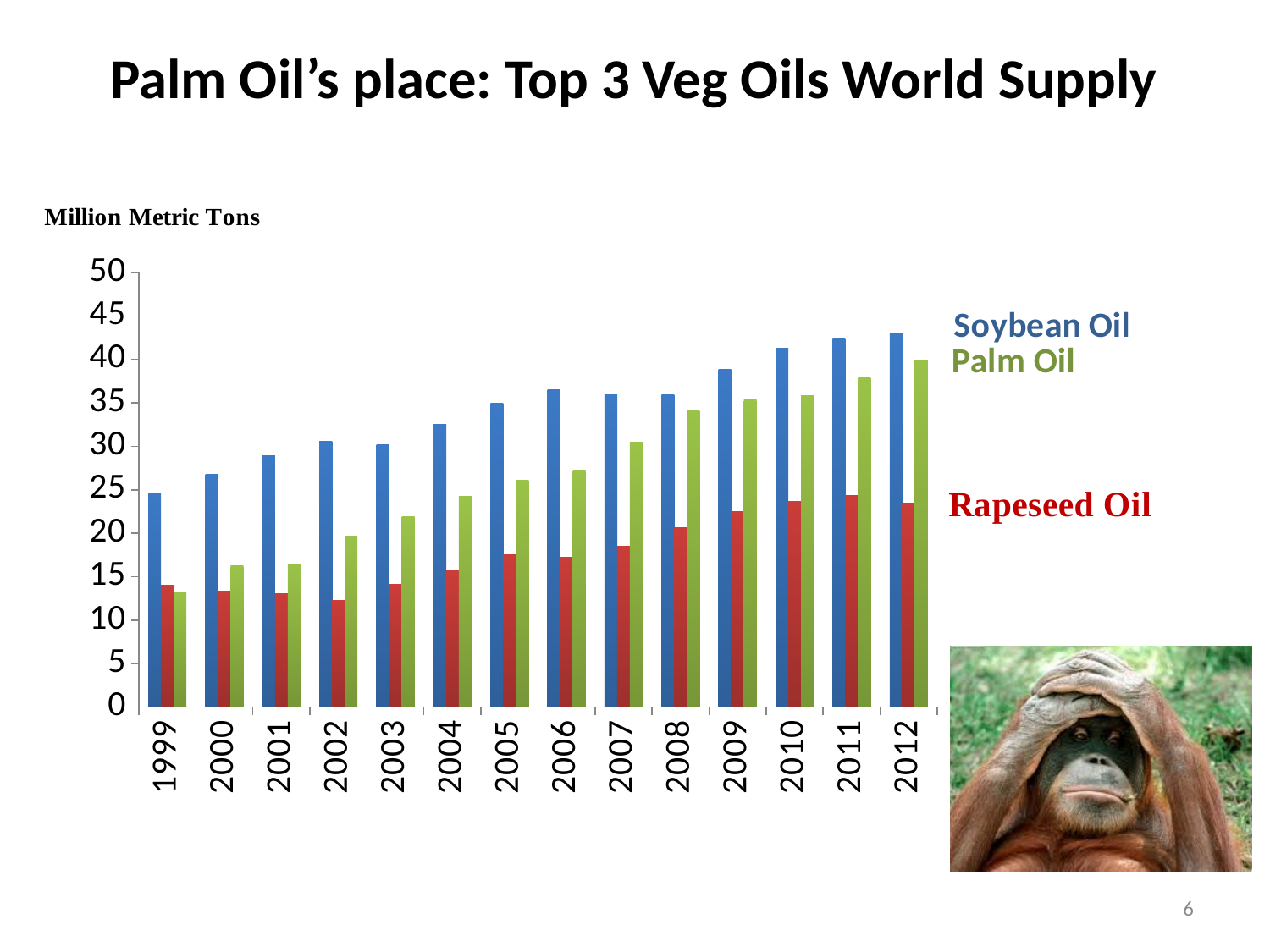
Is the Palm Oil value for 2008 greater or less than 30? greater Is the Soybean Oil value for 2012 greater or less than 40? greater How many series does the chart show? 3 In 2012, which is larger: Palm Oil or Rapeseed Oil? Palm Oil Is the Palm Oil value for 1999 greater or less than 15? less What unit is the chart's y axis measured in, according to the label above the chart? Million Metric Tons What kind of chart is shown on the slide? bar chart In which year is the Soybean Oil supply highest? 2012 Does the Palm Oil supply generally rise or fall from 1999 to 2012? rise In which year is the Rapeseed Oil supply lowest? 2002 How many years are shown along the x axis? 14 In 2000, which is larger: Palm Oil or Rapeseed Oil? Palm Oil